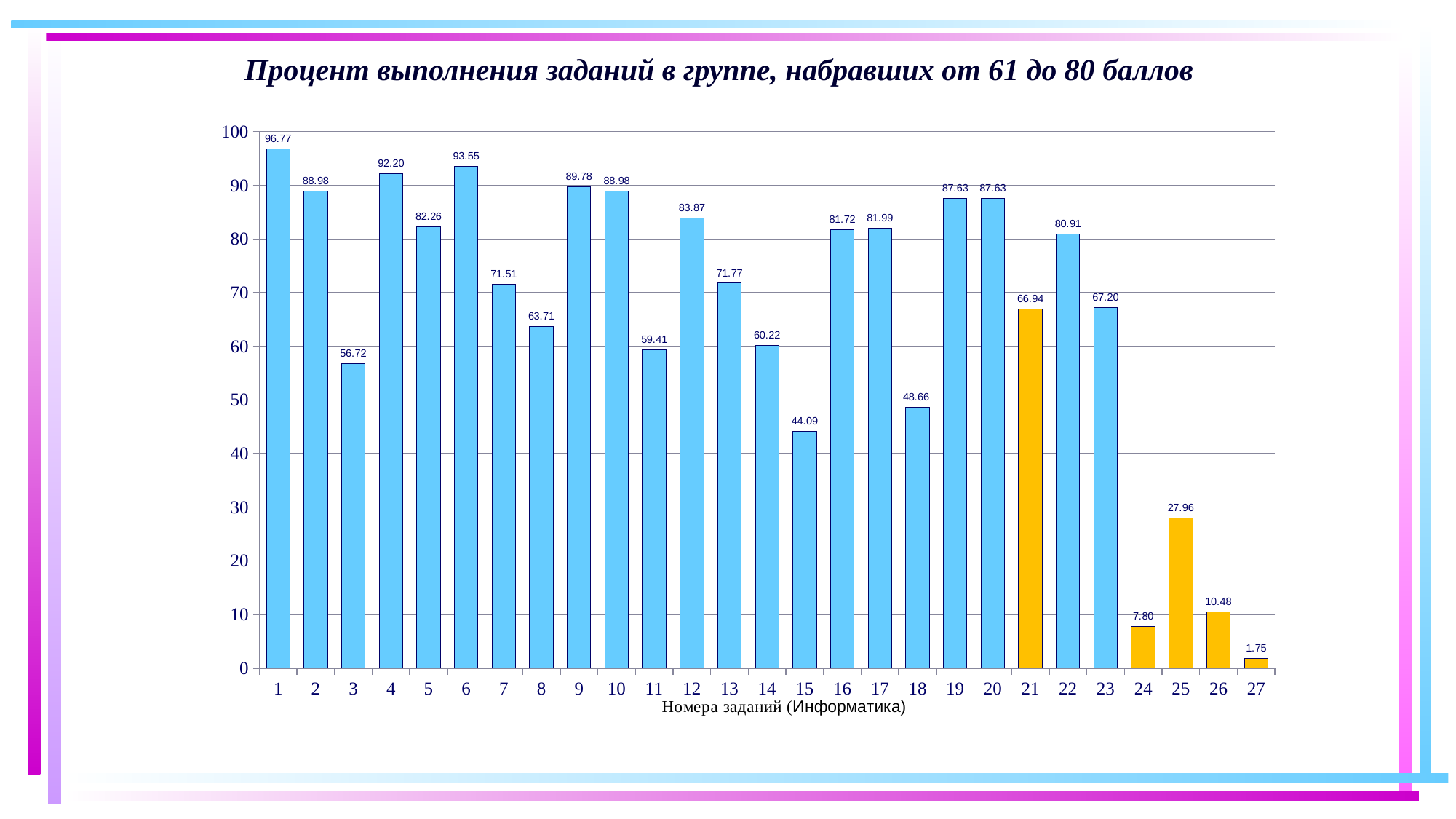
Which is larger, the value for task 12 or the value for task 13? task 12 What is the value for task 1? 96.77 How many bars are coloured orange rather than blue? 5 What is the difference between the values for task 1 and task 27? 95.02 What kind of chart is shown on the slide? bar chart Which task has the lowest value? 27 What is the value for task 15? 44.09 Which task has the highest value? 1 How many tasks are shown on the x axis? 27 What is the difference between the values for task 6 and task 4? 1.35 What is the value for task 21? 66.94 What is the value for task 27? 1.75